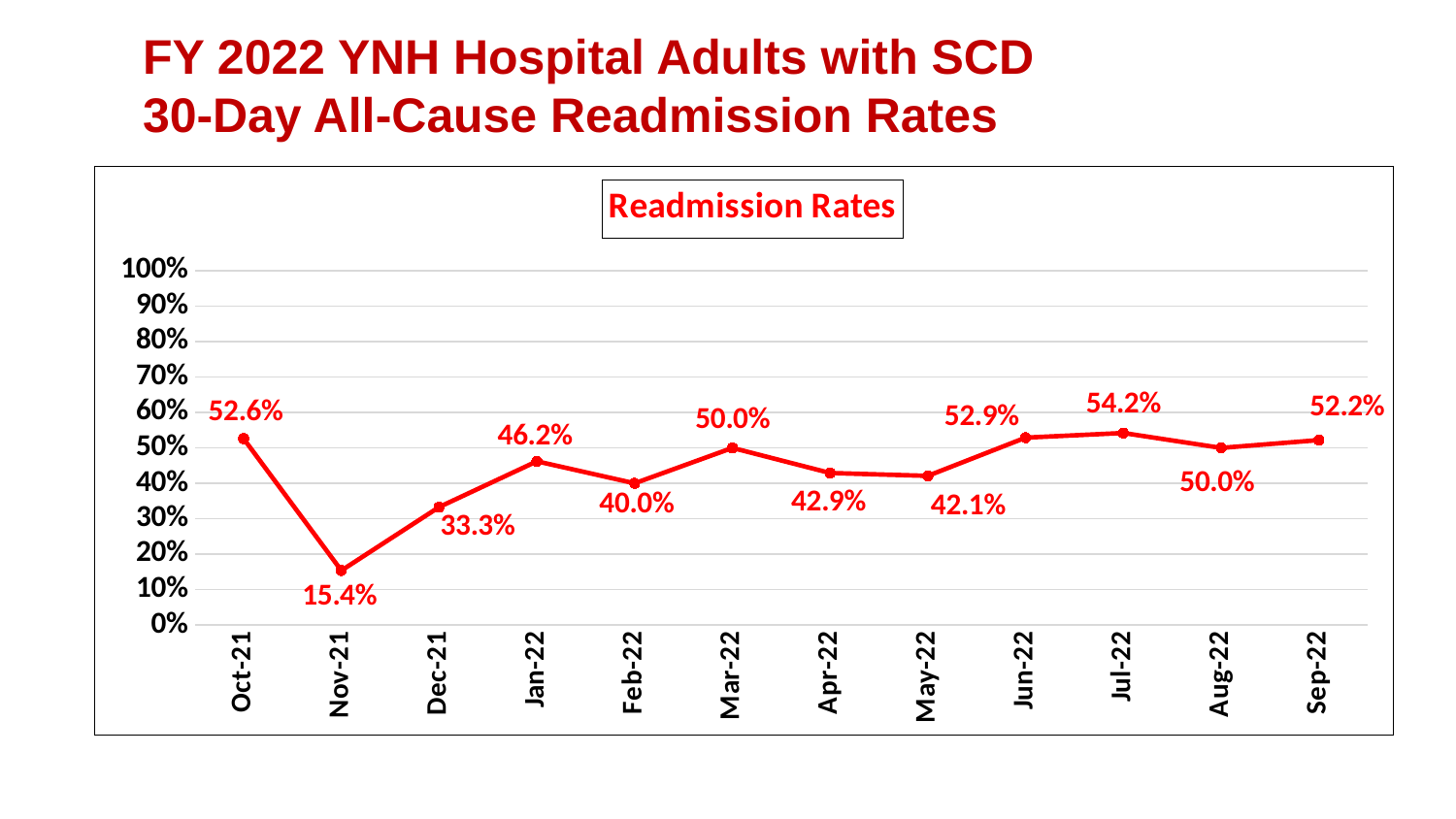
Which month has the highest readmission rate? Jul-22 Which month has the lowest readmission rate? Nov-21 What is the readmission rate for Nov-21? 15.4% Which is larger, the readmission rate for Jan-22 or for Feb-22? Jan-22 What is the readmission rate for Jul-22? 54.2% How many months are plotted on the chart? 12 Is the readmission rate for Dec-21 greater or less than 40%? less What is the title shown inside the chart area? Readmission Rates What kind of chart is shown on the slide? Line chart What is the readmission rate for Mar-22? 50.0% What is the difference between the readmission rates for Oct-21 and Nov-21? 37.2% Does the readmission rate rise or fall from Nov-21 to Jan-22? Rise